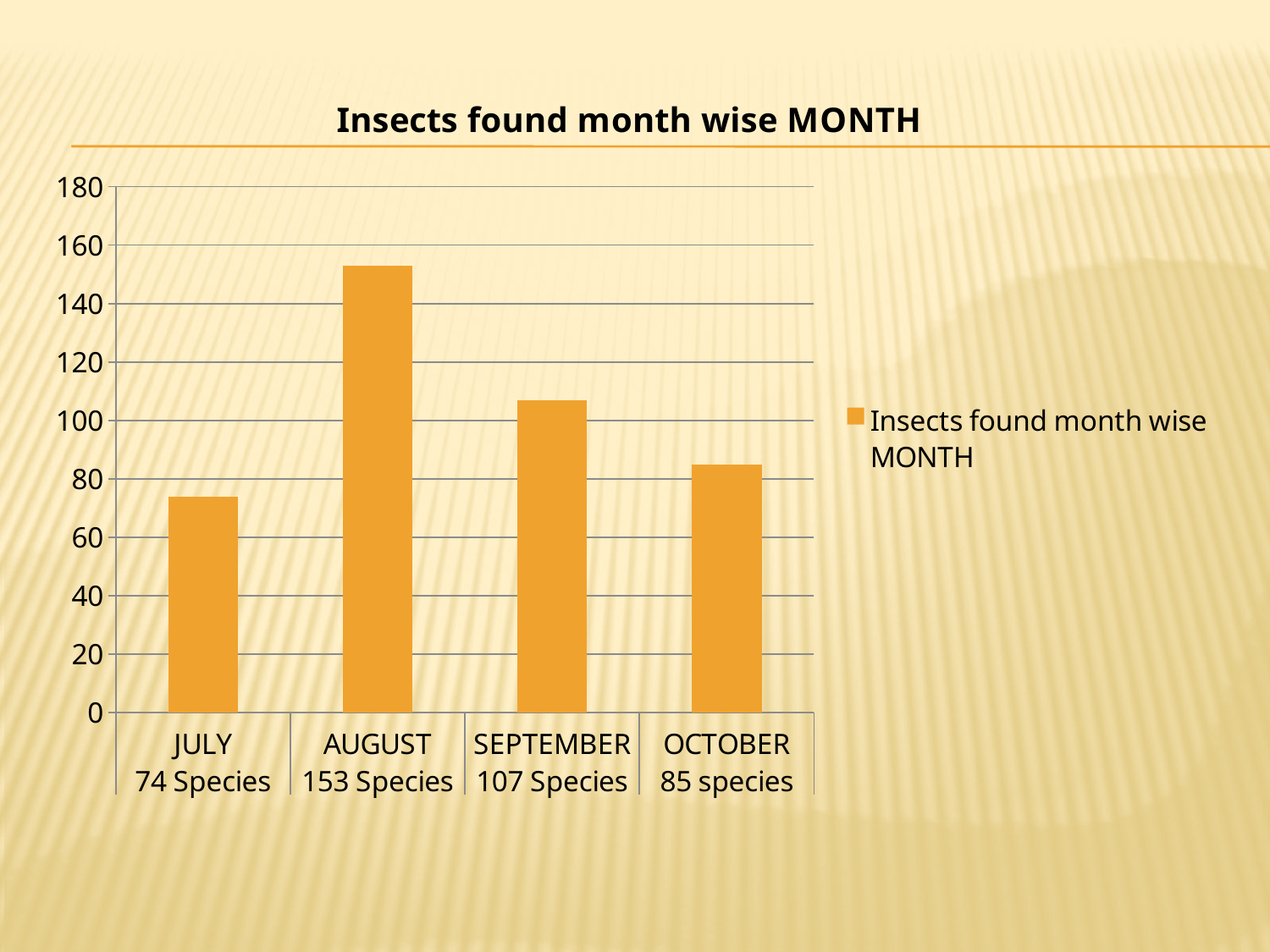
Which month has the lowest number of insect species found? JULY Is the value for August greater or less than 140? greater What kind of chart is shown on the slide? Bar chart Which month had more species found, September or October? SEPTEMBER Which month has the highest number of insect species found? AUGUST How many months are shown on the x axis? 4 How many species were found in August? 153 Species What is the title of the chart? Insects found month wise MONTH What is the difference between the number of species found in October and in July? 11 What is the difference between the number of species found in August and in September? 46 How many species were found in October? 85 species How many species were found in July? 74 Species